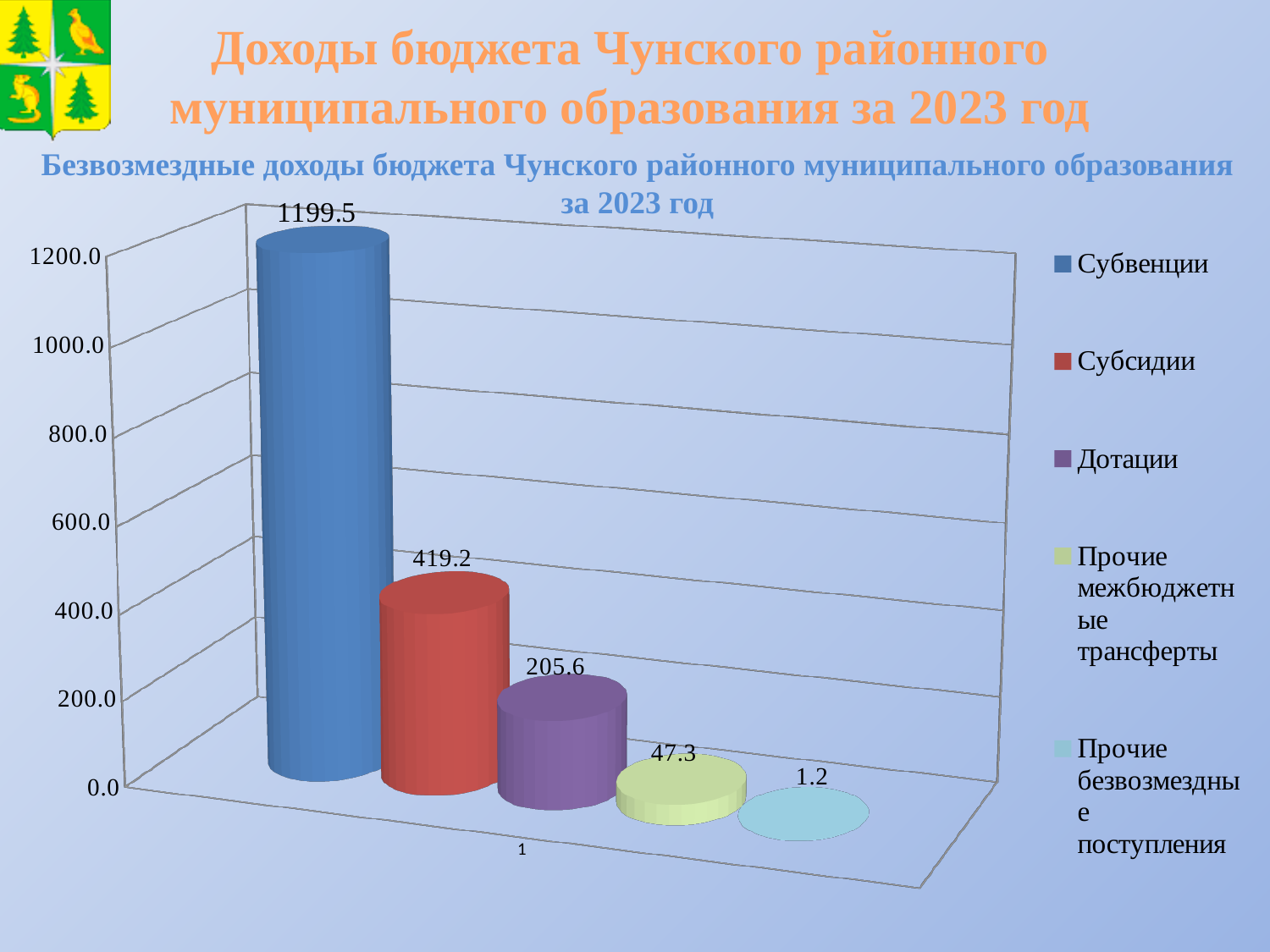
Which is larger, the value for Дотации or the value for Прочие межбюджетные трансферты? Дотации Which series has the highest value? Субвенции What is the value for Прочие безвозмездные поступления? 1.2 What is the value for Прочие межбюджетные трансферты? 47.3 What is the value for Субвенции? 1199.5 What is the value for Дотации? 205.6 What is the difference between the values for Субвенции and Субсидии? 780.3 What is the value for Субсидии? 419.2 How many series does the legend list? 5 What kind of chart is shown on the slide? Bar chart Is the value for Субсидии greater or less than 400.0? greater Which series has the lowest value? Прочие безвозмездные поступления